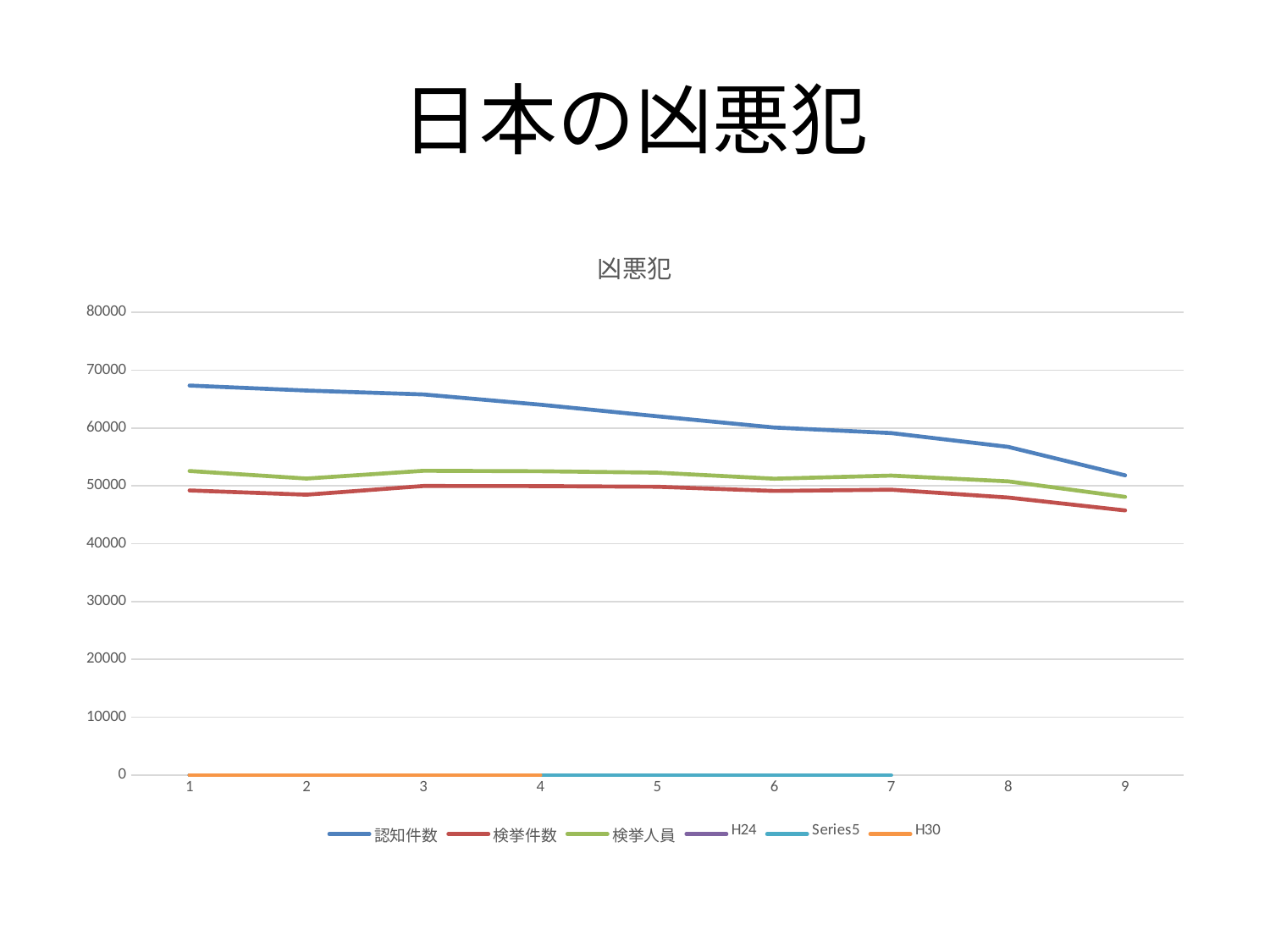
Does the 認知件数 line rise or fall from point 1 to point 9? fall Is the value for 認知件数 at point 1 greater or less than 60000? greater How many series does the legend of the chart list? 6 Among 認知件数, 検挙件数 and 検挙人員, which series is lowest at point 9? 検挙件数 What is the title shown above the chart? 凶悪犯 Is the value for 認知件数 at point 9 greater or less than 60000? less At point 1, which is larger: 認知件数 or 検挙件数? 認知件数 Which series has the highest values across the chart? 認知件数 Is the value for 検挙人員 at point 1 greater or less than 50000? greater What kind of chart is shown on the slide? line chart How many points are there along the x axis of the chart? 9